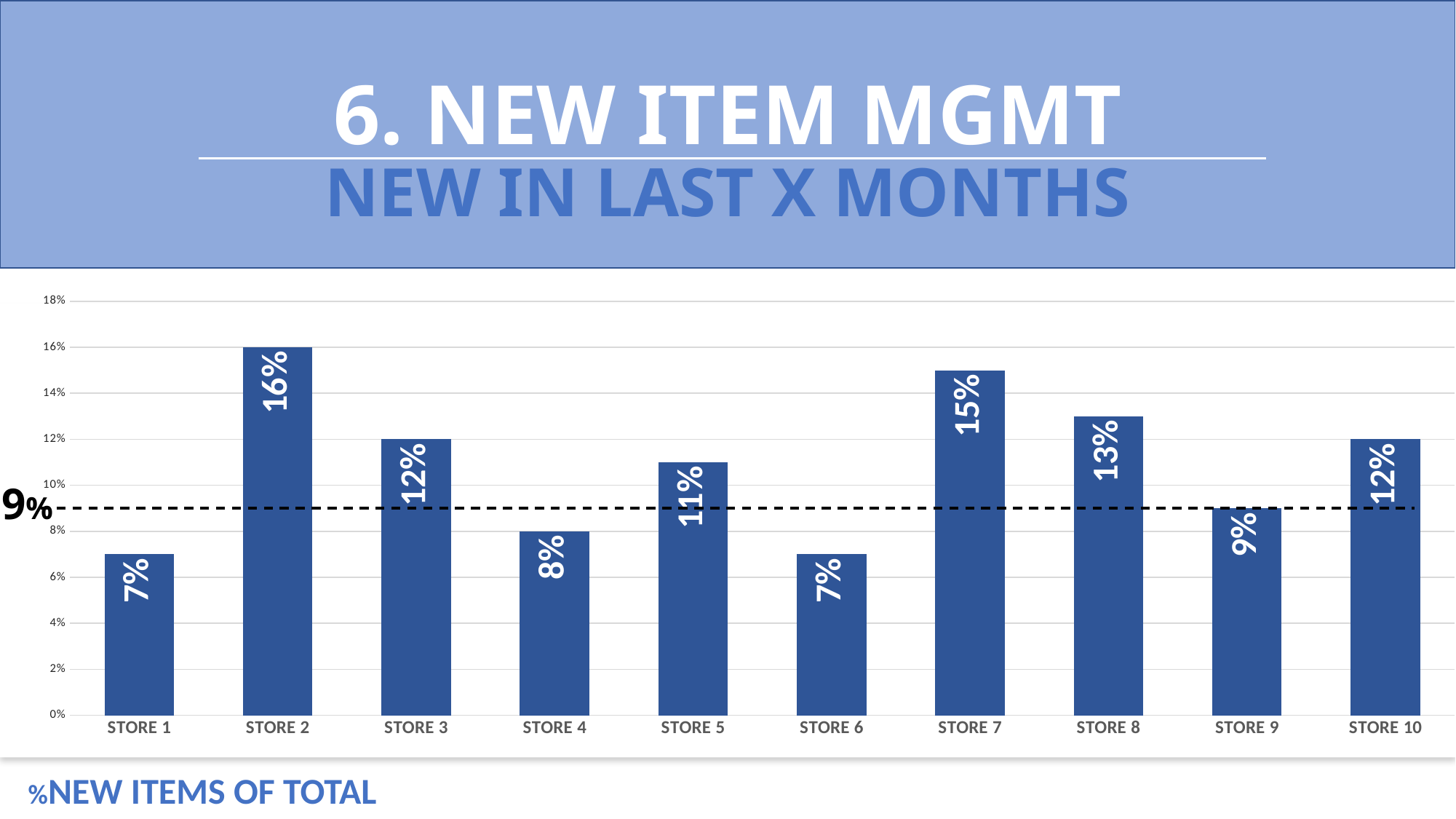
How many stores are shown on the chart? 10 Is the value for STORE 7 greater or less than 14%? greater What is the difference between the values for STORE 2 and STORE 1? 9% What is the difference between the values for STORE 7 and STORE 8? 2% What kind of chart is shown on the slide? bar chart What is the value for STORE 2? 16% What value does the dashed horizontal reference line mark? 9% Which store has the lowest value, STORE 4 or STORE 6? STORE 6 Which store has the highest value? STORE 2 Which is larger, the value for STORE 3 or the value for STORE 5? STORE 3 What is the value for STORE 5? 11% What is the value for STORE 9? 9%